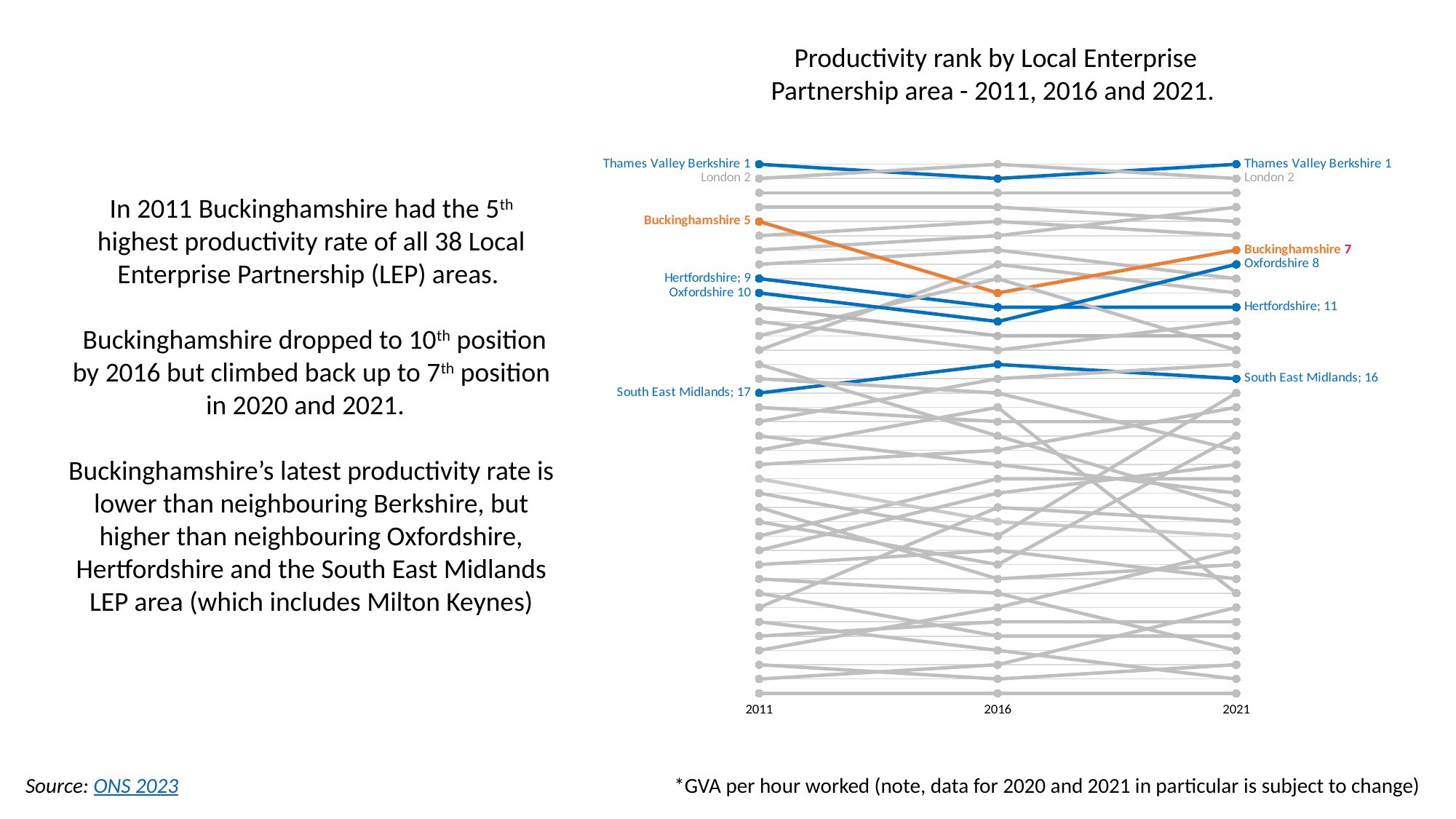
Which LEP area is ranked 1 in both 2011 and 2021? Thames Valley Berkshire In 2021, which has the better (lower-numbered) rank, Oxfordshire or Hertfordshire? Oxfordshire What colour is the line for Buckinghamshire on the chart? Orange What was Buckinghamshire's productivity rank in 2011 according to the chart? 5 By how many places did Buckinghamshire's rank change between 2011 (5) and 2021 (7)? 2 How many years are shown on the x axis of the chart? 3 What was Buckinghamshire's productivity rank in 2021 according to the chart? 7 What rank is shown for South East Midlands in 2021? 16 What rank is shown for Hertfordshire in 2011? 9 What type of chart is used to show the productivity ranks? Line chart What rank is shown for Oxfordshire in 2021? 8 What rank is shown for London in 2011? 2